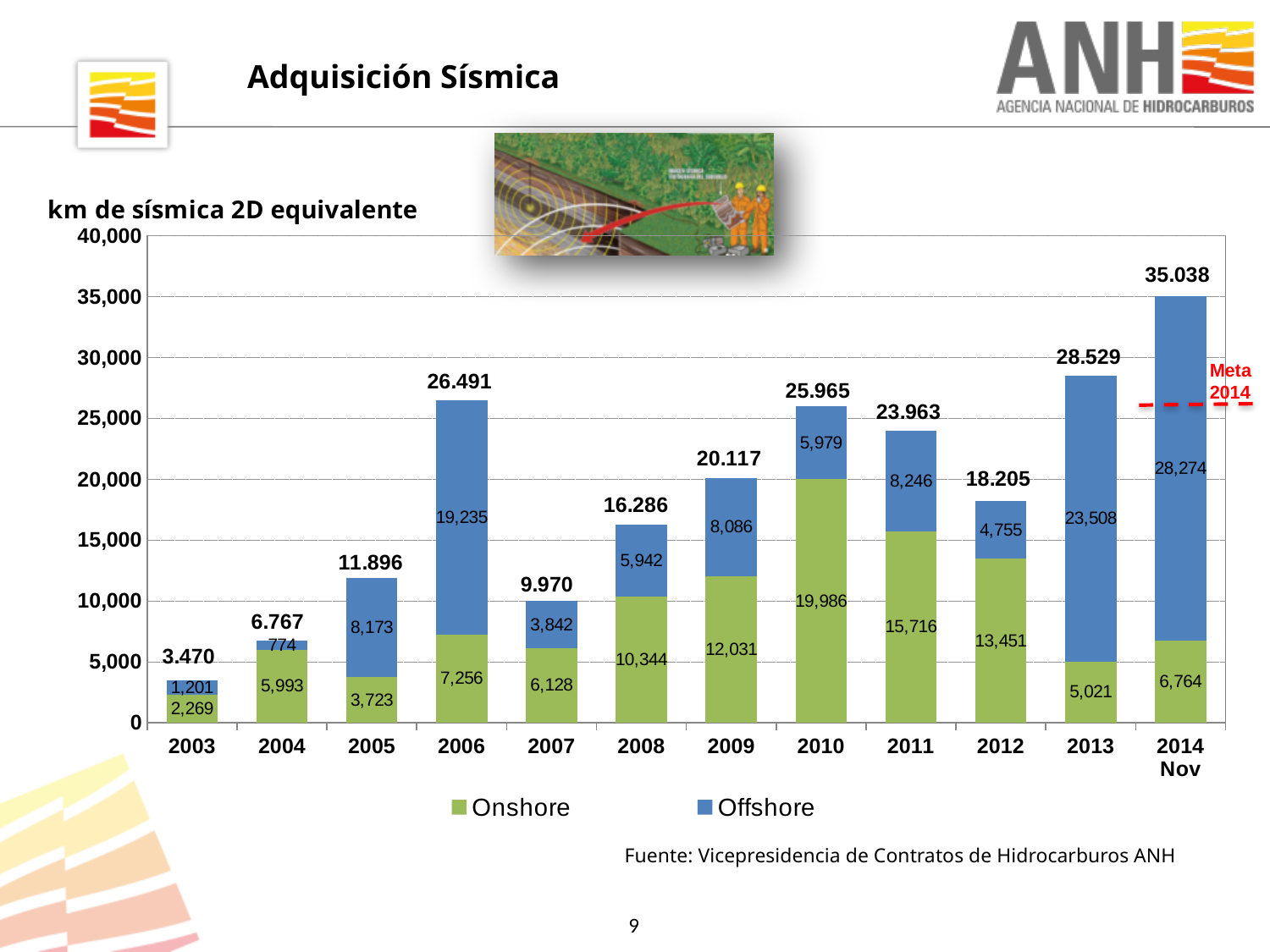
What is the Onshore value for 2010? 19,986 Which year has the highest total km de sísmica 2D equivalente? 2014 Nov What kind of chart is shown on the slide? Stacked bar chart How many years are shown on the x axis? 12 What is the Offshore value for 2013? 23,508 Which year has the lowest total km de sísmica 2D equivalente? 2003 Which year has the lowest Offshore value? 2004 Which is larger, the Offshore value for 2006 or the Offshore value for 2009? 2006 What is the total labelled above the bar for 2006? 26.491 What is the difference between the Onshore values for 2010 and 2011? 4,270 How many series does the legend list? 2 Is the total for 2013 greater or less than 25,000? greater